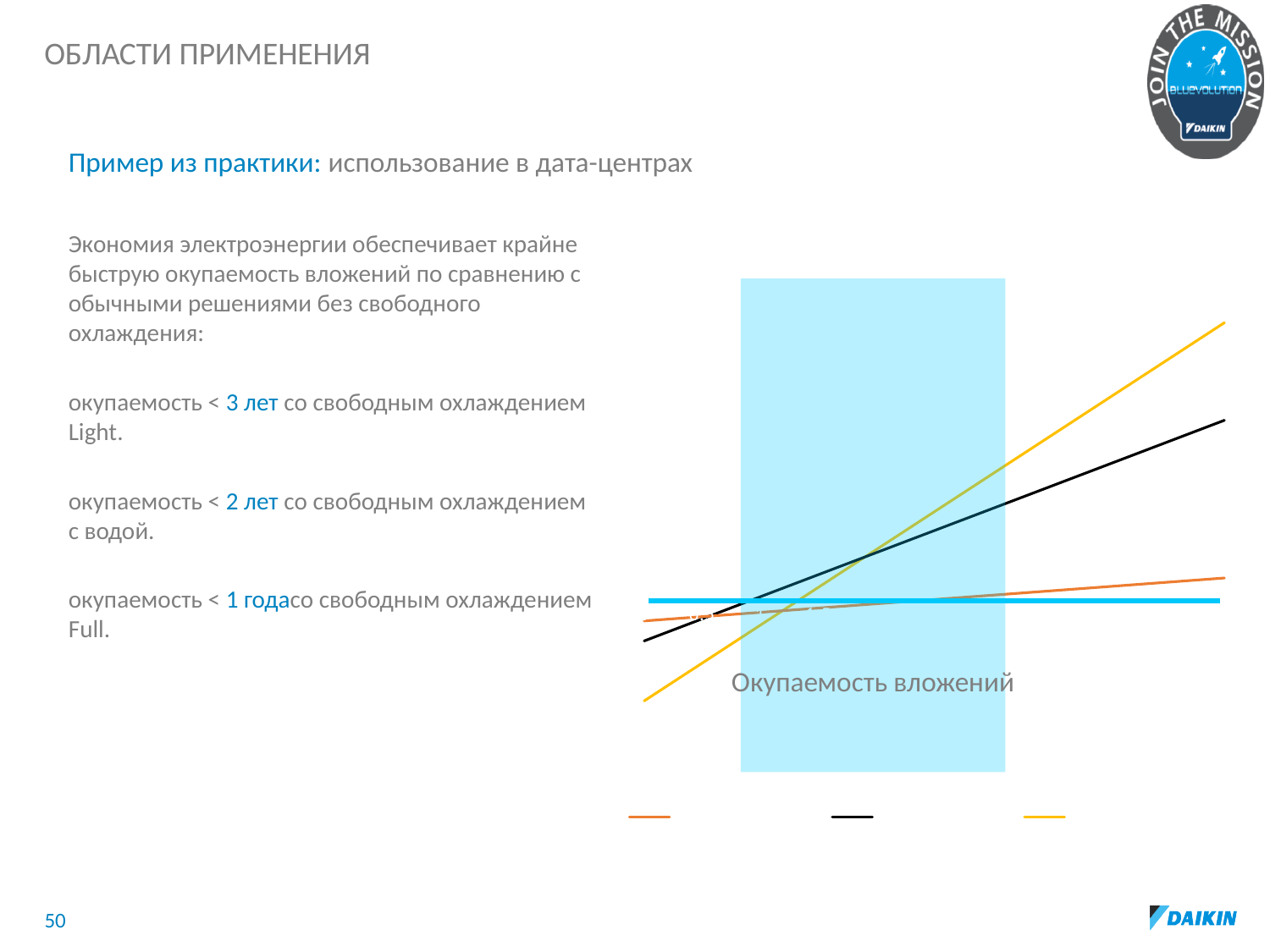
Do the plotted lines rise or fall from left to right? rise What title is printed on the chart? Окупаемость вложений How many series does the legend below the chart list? 3 What kind of chart is shown on the slide? line chart Which colour line in the chart rises most steeply? yellow